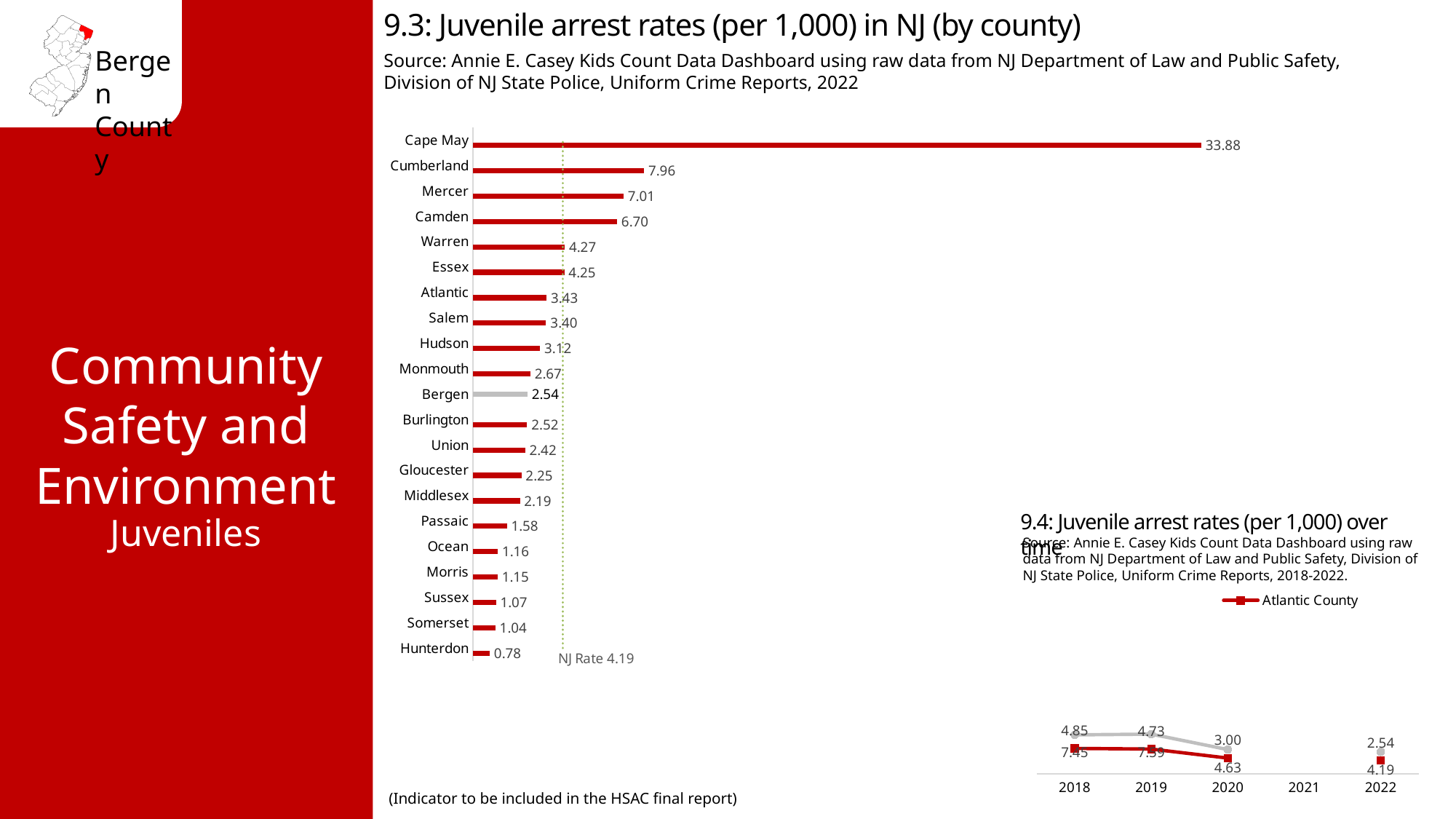
In chart 9.3, what NJ rate is marked by the dotted reference line? 4.19 In chart 9.3, which county has the highest juvenile arrest rate? Cape May In chart 9.4, what is the value of the red line in 2022? 4.19 In chart 9.3, how many counties are shown? 21 In chart 9.3, which county has the lowest juvenile arrest rate? Hunterdon In chart 9.4, does the gray line rise or fall from 2018 to 2022? Fall In chart 9.3, what is the difference between the rates for Cumberland and Mercer? 0.95 In chart 9.3, what is the juvenile arrest rate for Bergen? 2.54 In chart 9.4, what is the value of the gray line in 2020? 3.00 In chart 9.3, what is the juvenile arrest rate for Cape May? 33.88 What kind of chart is chart 9.3? Bar chart In chart 9.3, which county has a higher rate, Camden or Warren? Camden